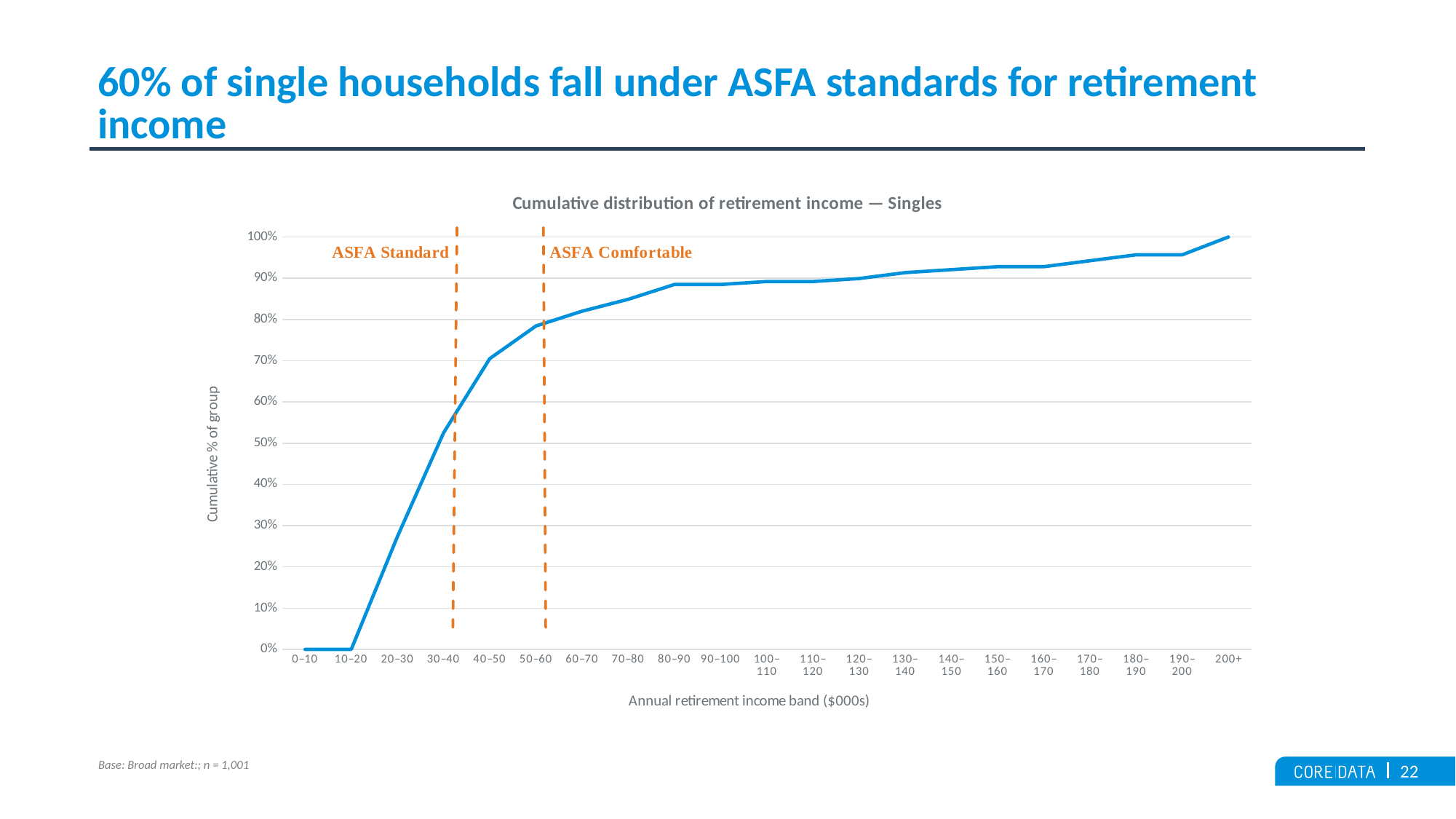
Is the value for the 20–30 income band greater or less than 40%? less How many income bands are shown on the x axis? 21 What is the title of the chart? Cumulative distribution of retirement income — Singles What kind of chart is shown on the slide? line chart What is the cumulative % of group for the 0–10 income band? 0% Which income band has the highest cumulative % of group? 200+ Do the values rise or fall as you move along the x axis from 0–10 to 200+? rise Is the value for the 30–40 income band greater or less than 50%? greater What is the cumulative % of group for the 200+ income band? 100% Which is larger, the value for the 40–50 band or the value for the 20–30 band? 40–50 What are the labels on the two orange dashed vertical lines? ASFA Standard and ASFA Comfortable Is the value for the 80–90 income band greater or less than 80%? greater